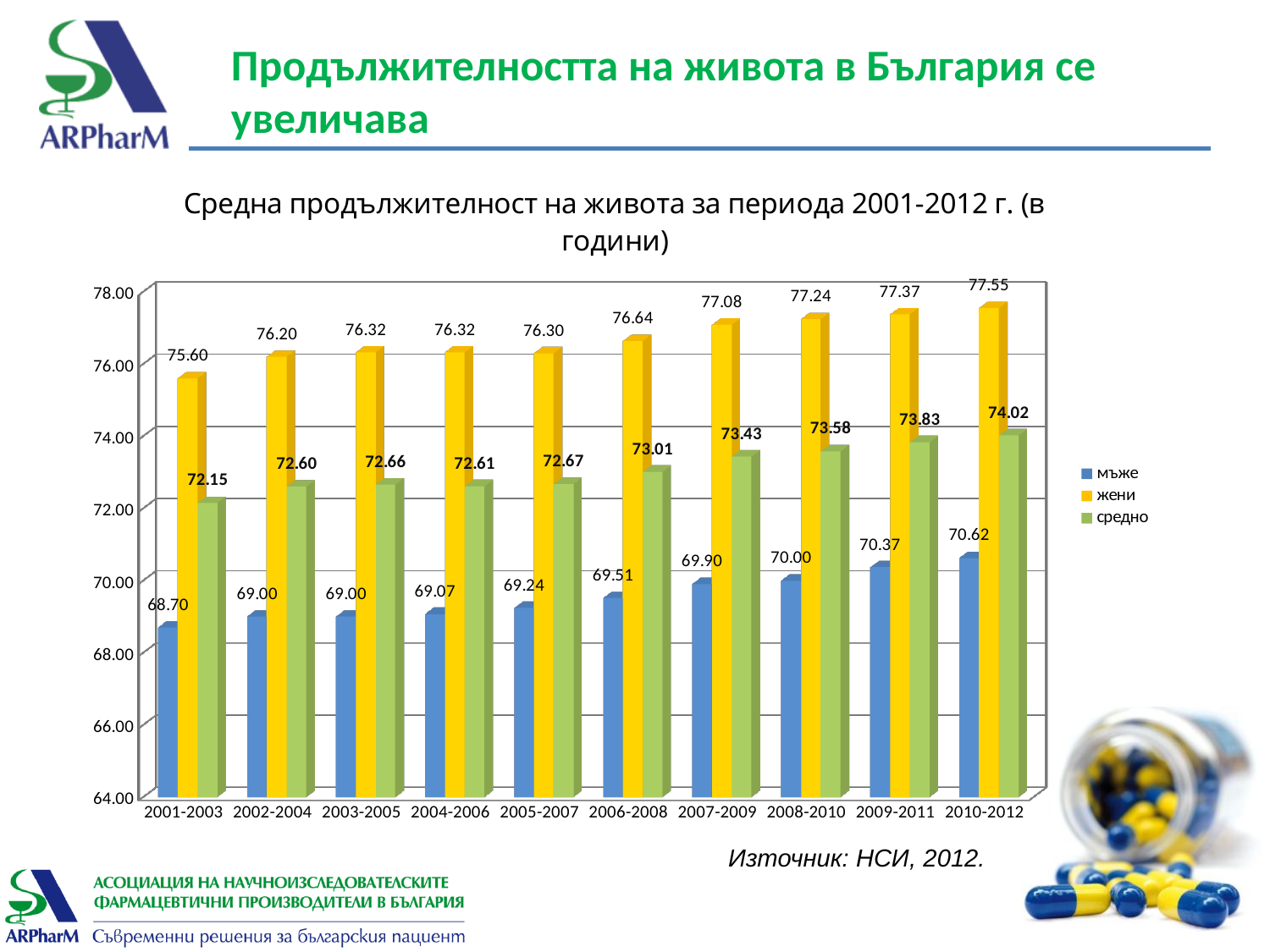
How many periods are shown on the x axis? 10 In which period is the value for мъже lowest? 2001-2003 Is the value for мъже in 2008-2010 greater or less than 72.00? less What kind of chart is shown on the slide? bar chart In which period is the value for жени highest? 2010-2012 Which is larger in 2005-2007: the value for средно or the value for мъже? средно Do the values for средно rise or fall from 2001-2003 to 2010-2012? rise What is the value for средно in 2007-2009? 73.43 What is the value for мъже in 2010-2012? 70.62 What is the value for жени in 2001-2003? 75.60 How many series does the legend list? 3 What is the difference between the жени and мъже values in 2010-2012? 6.93